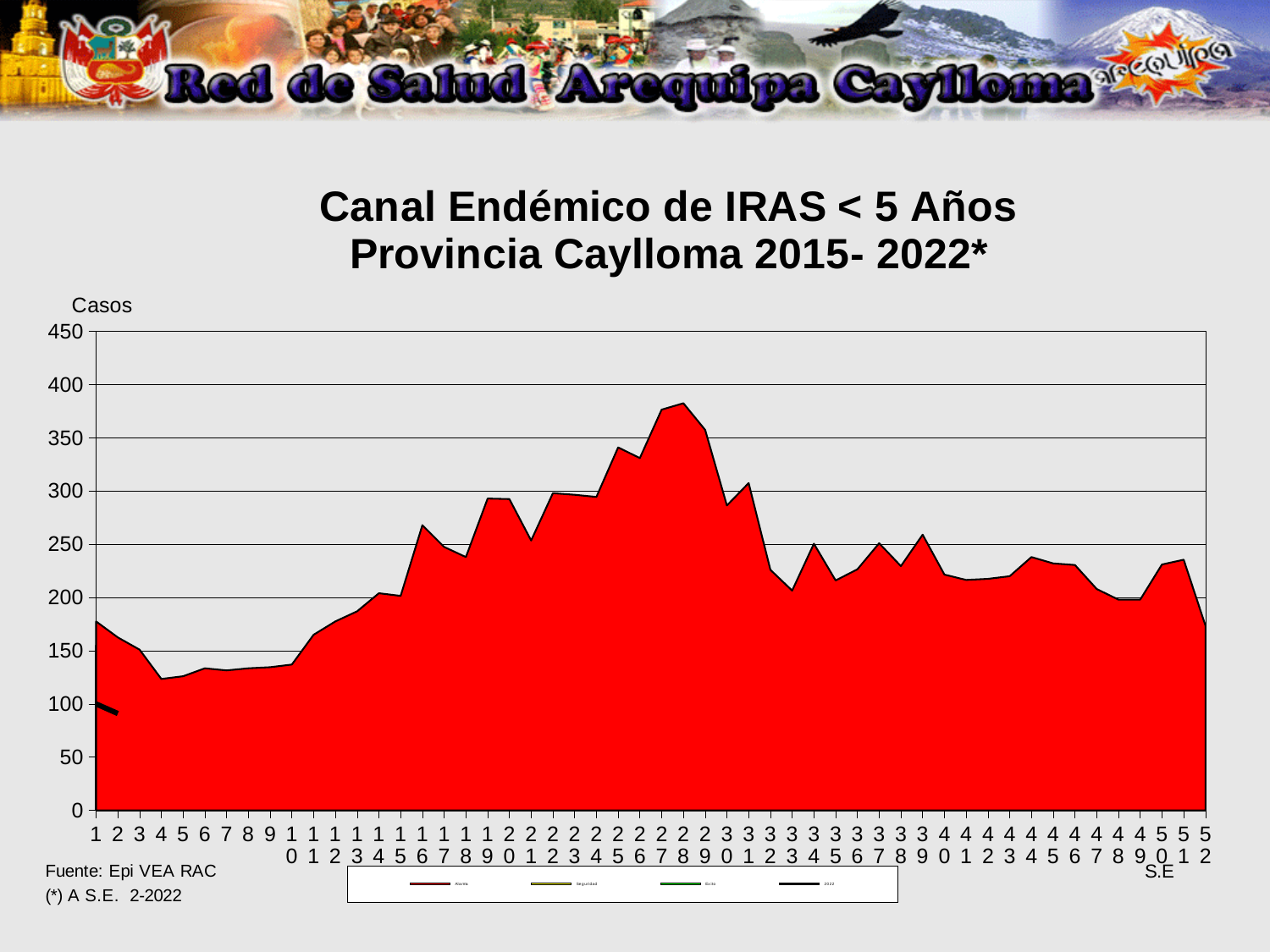
What kind of chart is shown on the slide? area chart Which week has the highest value of the red area? 28 What is the maximum value shown on the vertical axis? 450 Is the value of the red area at week 20 greater or less than 250? greater Is the value of the red area at week 33 greater or less than 250? less Do the values of the red area rise or fall from week 1 to week 4? fall How many epidemiological weeks (S.E) are plotted along the x axis? 52 What label is shown on the vertical axis of the chart? Casos Is the value of the red area at week 4 greater or less than 150? less What is the title of the chart? Canal Endémico de IRAS < 5 Años Provincia Caylloma 2015- 2022* Which has a larger value of the red area, week 1 or week 10? week 1